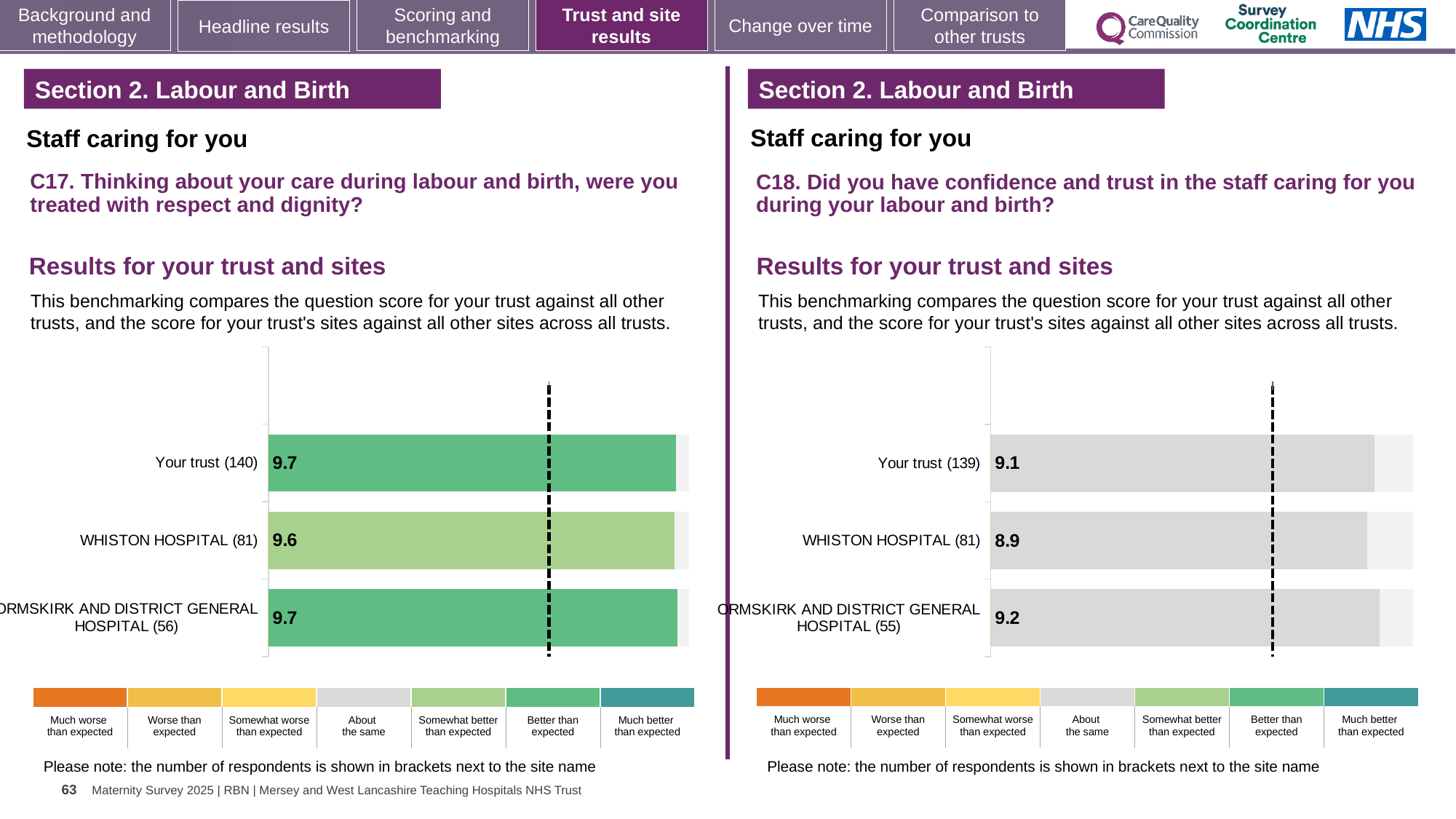
In the C18 chart on the right, what is the difference between the scores for ORMSKIRK AND DISTRICT GENERAL HOSPITAL (55) and WHISTON HOSPITAL (81)? 0.3 In the C18 chart on the right, which site or trust has the highest score? ORMSKIRK AND DISTRICT GENERAL HOSPITAL (55) In the C18 chart on the right, which benchmark category does the grey colour of the bars correspond to in the legend? About the same In the C17 chart on the left, which is larger: the score for Your trust (140) or for WHISTON HOSPITAL (81)? Your trust (140) In the C18 chart on the right, what is the score for ORMSKIRK AND DISTRICT GENERAL HOSPITAL (55)? 9.2 How many bars are shown in the C17 chart on the left? 3 What type of chart is used for the C18 results on the right? Bar chart In the C17 chart on the left, which has the lowest score? WHISTON HOSPITAL (81) In the C17 chart on the left, what is the score for Your trust (140)? 9.7 In the C18 chart on the right, what is the score for Your trust (139)? 9.1 In the C17 chart on the left, what is the score for WHISTON HOSPITAL (81)? 9.6 In the C18 chart on the right, which site or trust has the lowest score? WHISTON HOSPITAL (81)